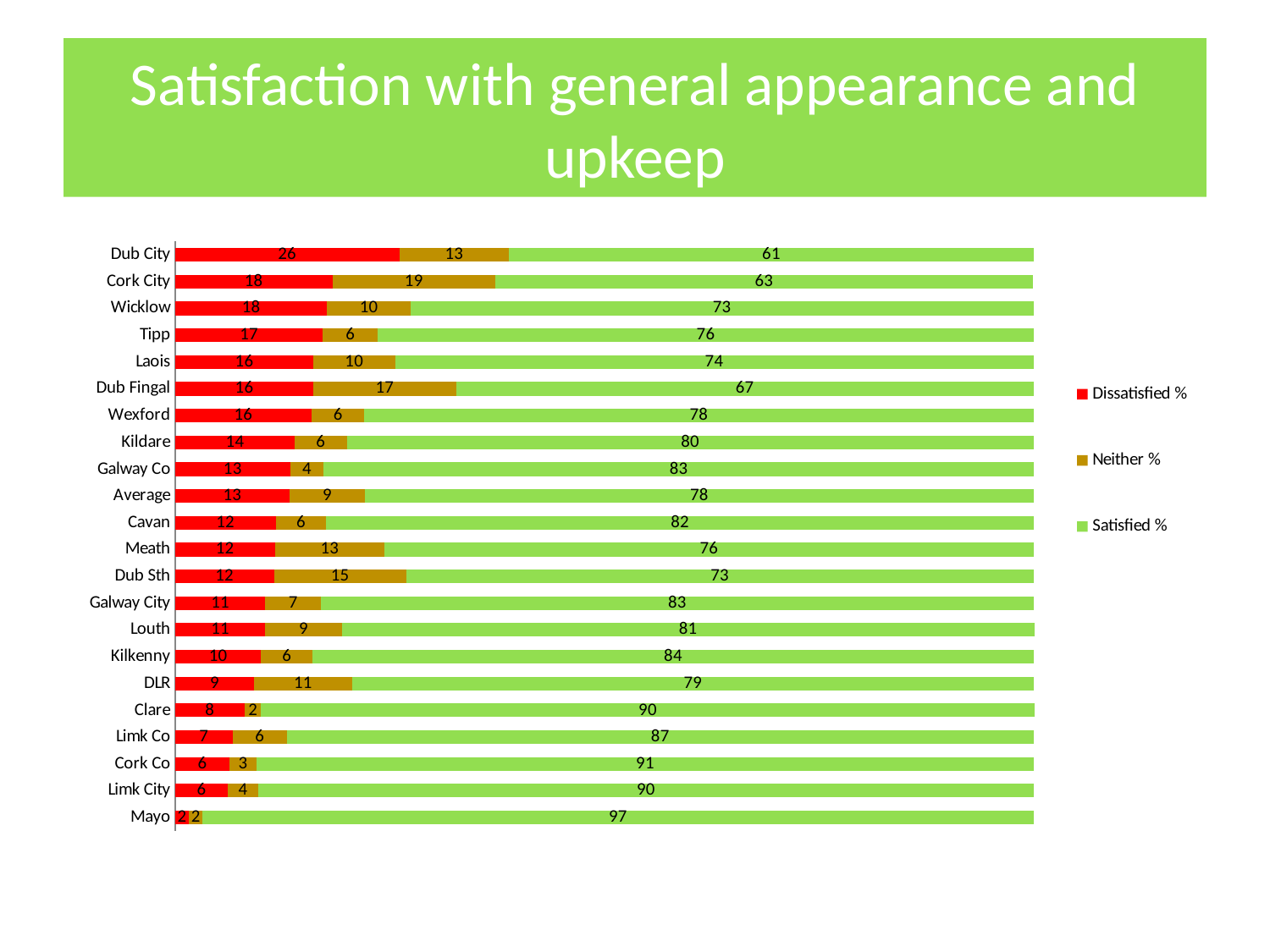
What is the Satisfied % value for Wicklow? 73 What is the difference between the Satisfied % values for Mayo and Dub City? 36 What is the total of the stacked bar for Dub Fingal? 100 Which category has the lowest Satisfied % value? Dub City What kind of chart is shown on the slide? Stacked bar chart How many series does the legend list? 3 Which has a larger Dissatisfied % value, Kilkenny or DLR? Kilkenny Which category has the highest Satisfied % value? Mayo What is the Neither % value for Dub Fingal? 17 How many categories are shown on the chart? 22 What is the Dissatisfied % value for Dub City? 26 Which category has the highest Neither % value? Cork City